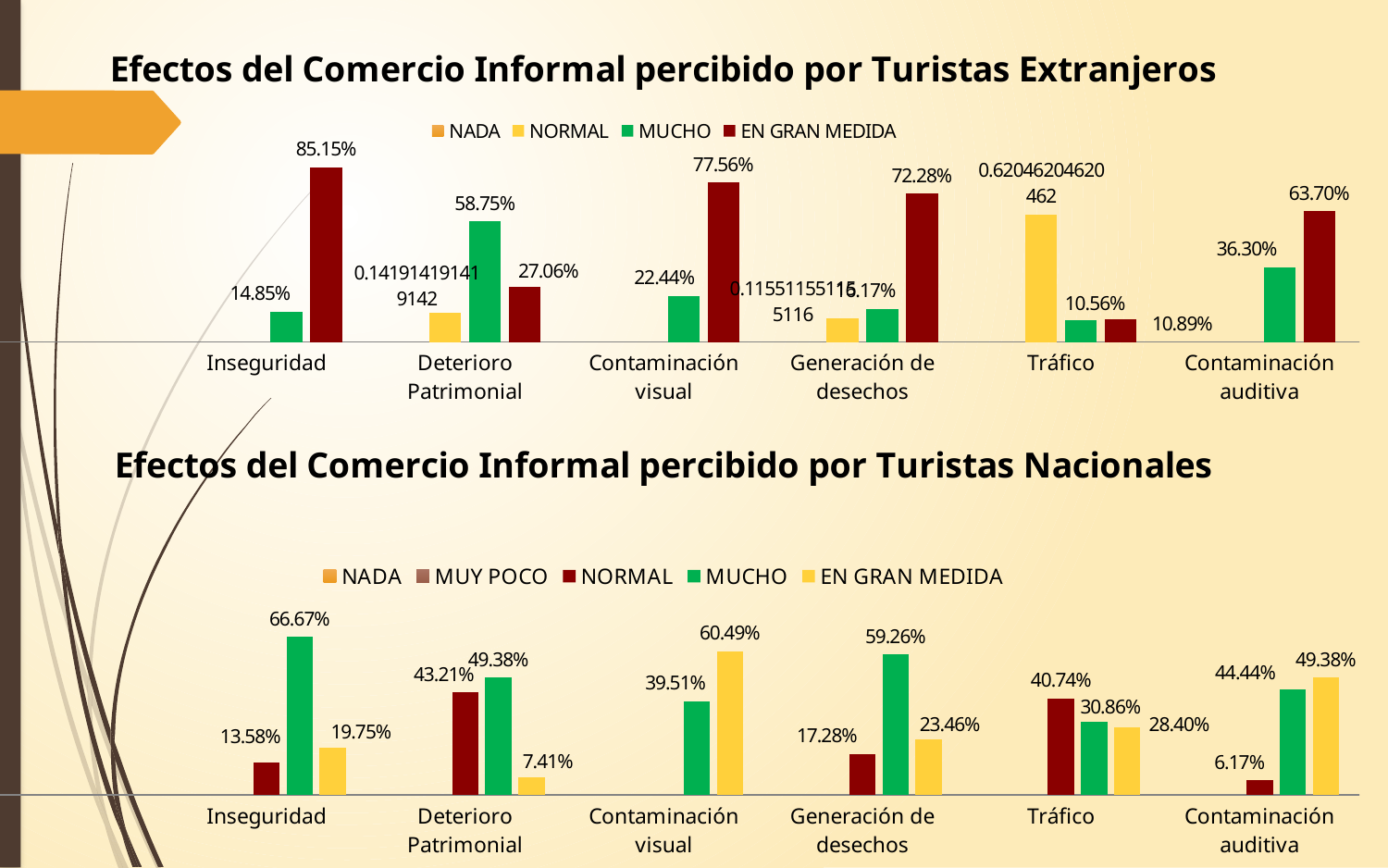
In the chart 'Efectos del Comercio Informal percibido por Turistas Nacionales', which is larger for Tráfico: the NORMAL value or the MUCHO value? NORMAL In the chart 'Efectos del Comercio Informal percibido por Turistas Extranjeros', what is the difference between the EN GRAN MEDIDA and MUCHO values for Contaminación visual? 55.12% In the chart 'Efectos del Comercio Informal percibido por Turistas Extranjeros', which category has the highest EN GRAN MEDIDA value? Inseguridad In the chart 'Efectos del Comercio Informal percibido por Turistas Nacionales', which category has the lowest EN GRAN MEDIDA value? Deterioro Patrimonial In the chart 'Efectos del Comercio Informal percibido por Turistas Extranjeros', what is the EN GRAN MEDIDA value for Inseguridad? 85.15% How many series does the legend of the chart 'Efectos del Comercio Informal percibido por Turistas Nacionales' list? 5 How many series does the legend of the chart 'Efectos del Comercio Informal percibido por Turistas Extranjeros' list? 4 How many categories are shown on the x axis of the chart 'Efectos del Comercio Informal percibido por Turistas Nacionales'? 6 What type of chart is 'Efectos del Comercio Informal percibido por Turistas Nacionales'? Bar chart In the chart 'Efectos del Comercio Informal percibido por Turistas Nacionales', what is the difference between the EN GRAN MEDIDA and NORMAL values for Contaminación auditiva? 43.21% In the chart 'Efectos del Comercio Informal percibido por Turistas Extranjeros', what is the MUCHO value for Deterioro Patrimonial? 58.75% In the chart 'Efectos del Comercio Informal percibido por Turistas Nacionales', what is the MUCHO value for Inseguridad? 66.67%